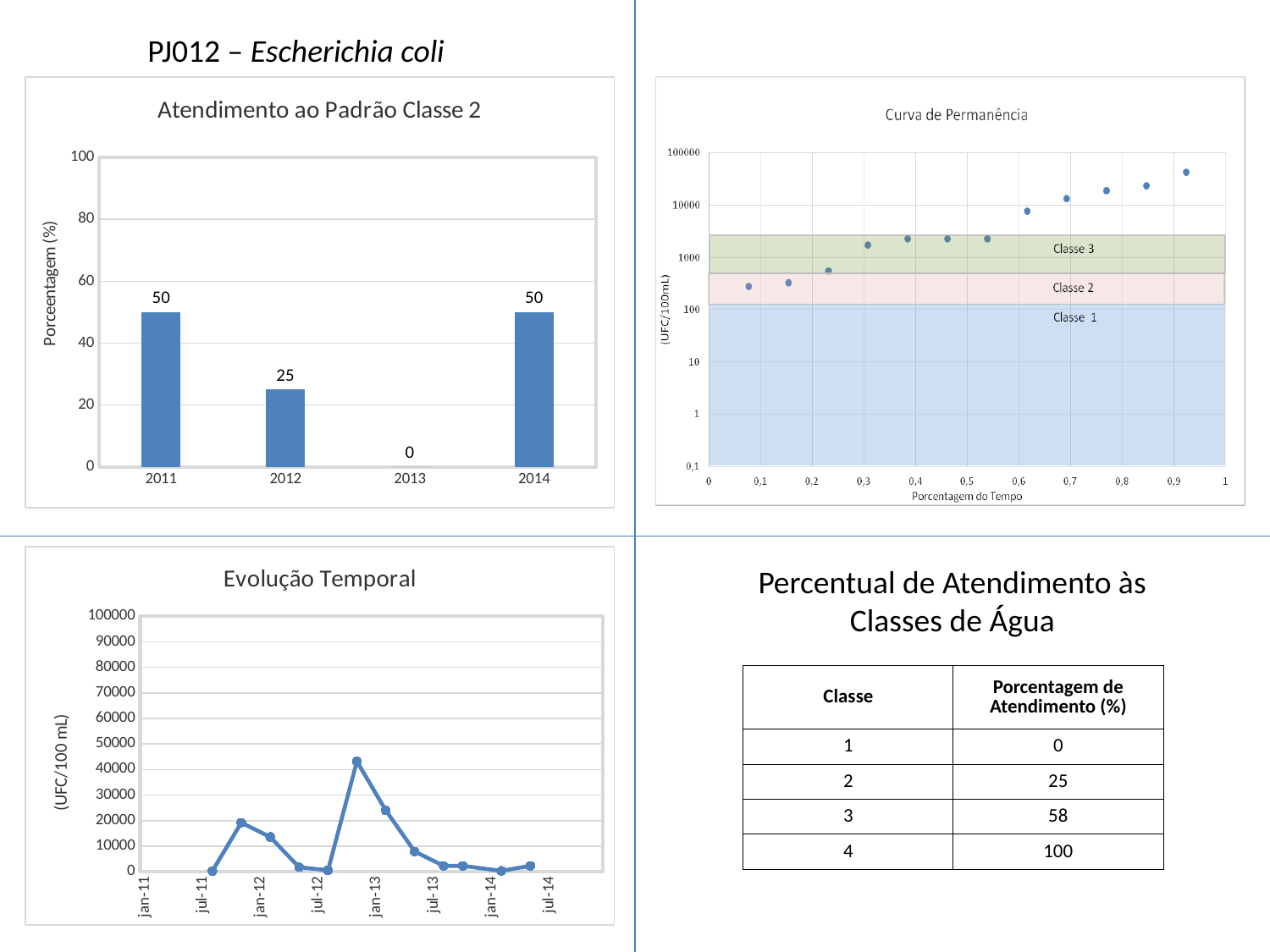
What is the x-axis title of the 'Curva de Permanência' chart? Porcentagem do Tempo In the 'Atendimento ao Padrão Classe 2' chart, what is the value for 2012? 25 What is the y-axis title of the 'Atendimento ao Padrão Classe 2' chart? Porceentagem (%) How many years are shown in the 'Atendimento ao Padrão Classe 2' chart? 4 In the 'Evolução Temporal' chart, is the highest point (near jan-13) greater or less than 40000? greater In the 'Curva de Permanência' chart, is the value of the leftmost point (near 0,1 on the x axis) greater or less than 1000? less In the 'Atendimento ao Padrão Classe 2' chart, which is larger, the value for 2012 or the value for 2014? 2014 In the 'Atendimento ao Padrão Classe 2' chart, what is the value for 2014? 50 In the 'Atendimento ao Padrão Classe 2' chart, which year has the lowest value? 2013 What kind of chart is 'Atendimento ao Padrão Classe 2'? bar chart In the 'Atendimento ao Padrão Classe 2' chart, what is the difference between the values for 2011 and 2012? 25 In the 'Curva de Permanência' chart, is the value of the rightmost point (near 0,9 on the x axis) greater or less than 10000? greater